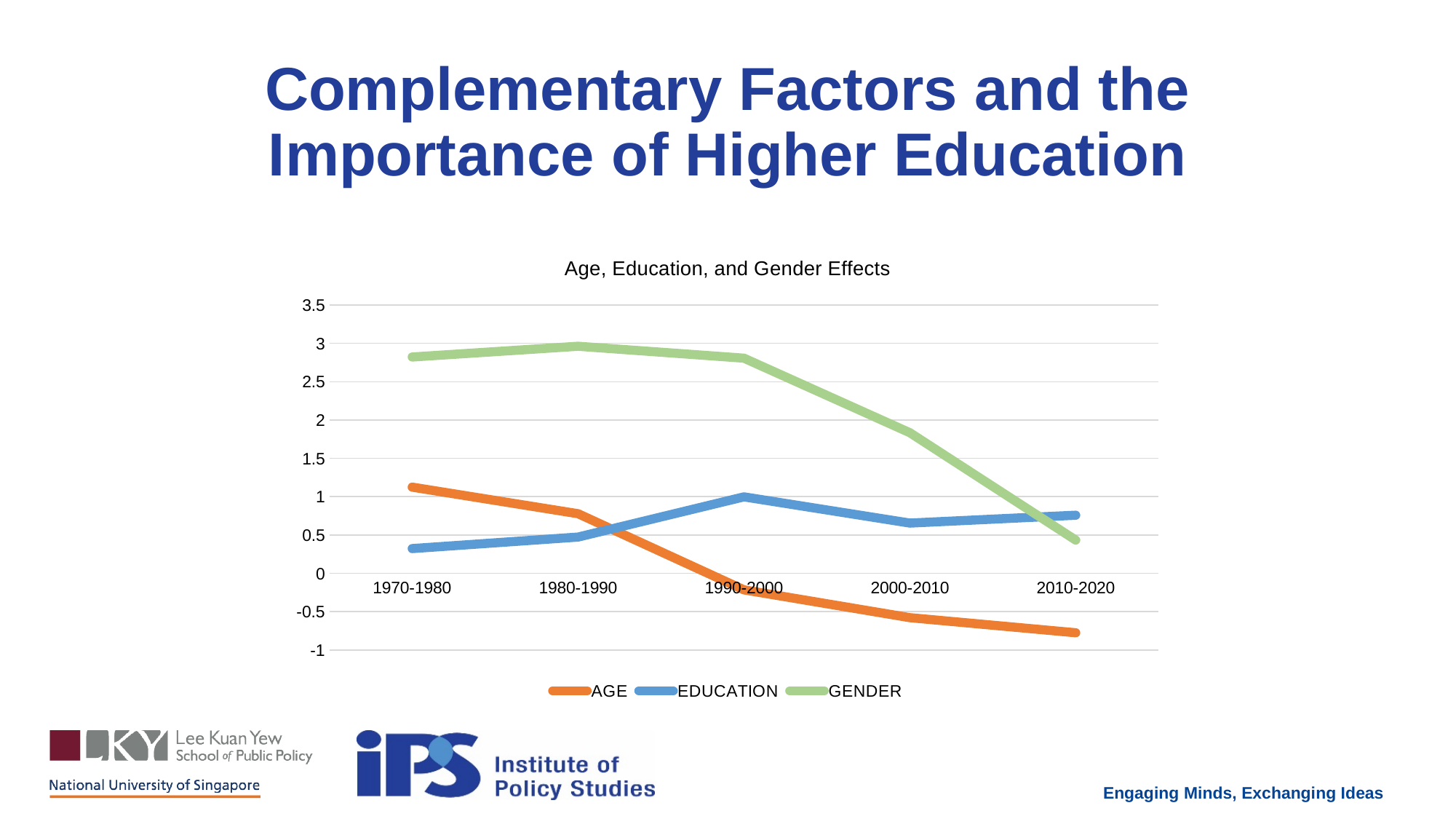
What kind of chart is shown on the slide? line chart In 1970-1980, which is larger, the AGE value or the EDUCATION value? AGE How many time periods are shown on the x axis? 5 What is the title of the chart? Age, Education, and Gender Effects Which series has the lowest value in 2010-2020? AGE How many series does the legend list? 3 Is the GENDER value for 1970-1980 greater or less than 2.5? greater Which series is drawn in green? GENDER Which series has the highest value in 1970-1980? GENDER Does the AGE series rise or fall from 1970-1980 to 2010-2020? fall Is the AGE value for 2010-2020 greater or less than -0.5? less Is the EDUCATION value for 1970-1980 greater or less than 0.5? less